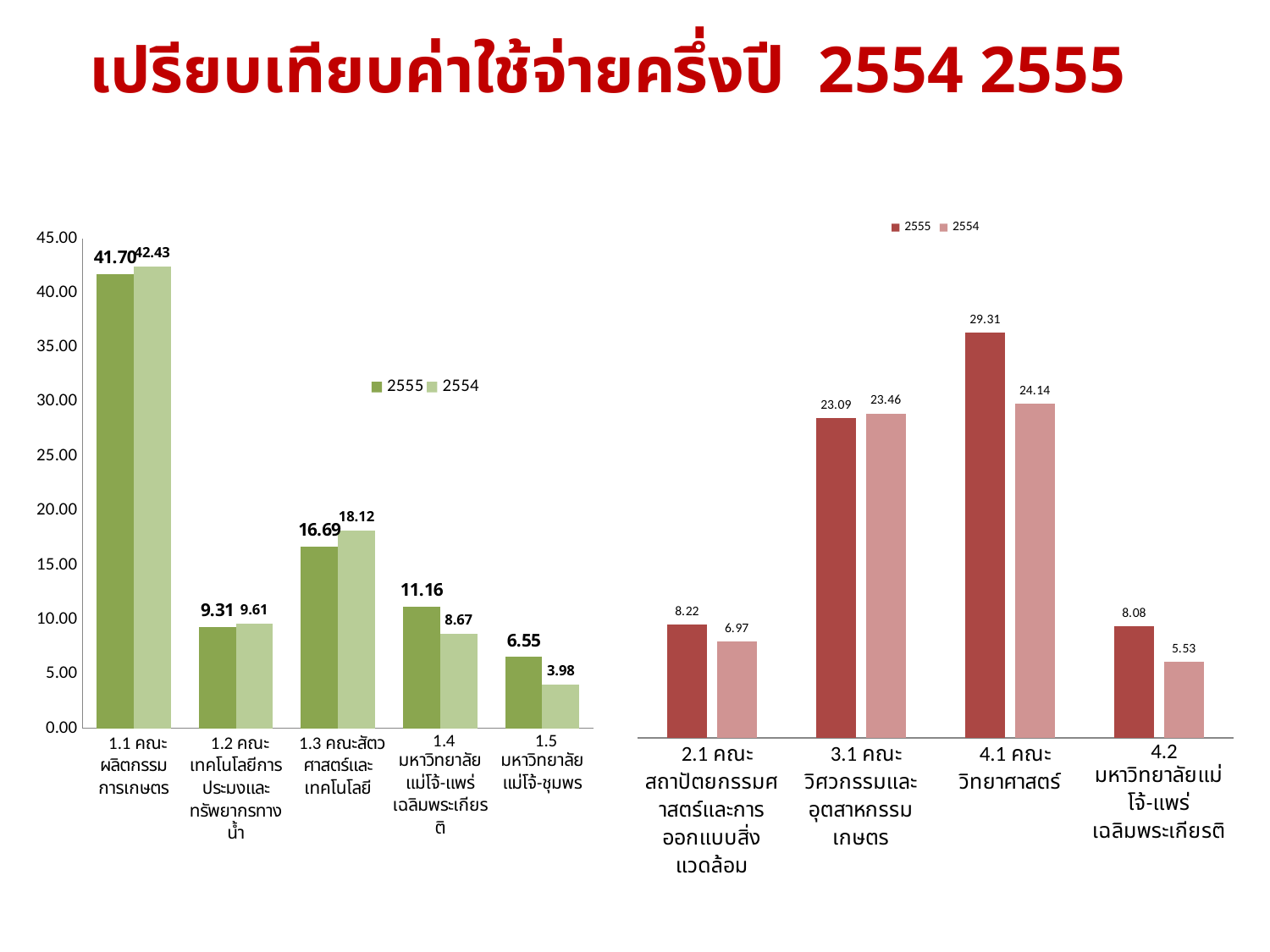
What type of chart is the right chart? Bar chart In the right chart, what is the 2555 value for category 4.1 (คณะวิทยาศาสตร์)? 29.31 In the right chart, what is the 2554 value for category 2.1? 6.97 How many series does the legend of the left chart list? 2 In the left chart, what is the 2554 value for category 1.5 (มหาวิทยาลัยแม่โจ้-ชุมพร)? 3.98 In the left chart, what is the 2555 value for category 1.1 (คณะผลิตกรรมการเกษตร)? 41.70 In the left chart, what is the difference between the 2554 and 2555 values for category 1.3? 1.43 In the left chart, which category has the highest 2555 value? 1.1 คณะผลิตกรรมการเกษตร In the right chart, what is the difference between the 2555 and 2554 values for category 4.1? 5.17 In the left chart, for category 1.4, which series has the larger value, 2555 or 2554? 2555 How many categories are shown on the x axis of the right chart? 4 In the right chart, which category has the lowest 2554 value? 4.2 มหาวิทยาลัยแม่โจ้-แพร่ เฉลิมพระเกียรติ